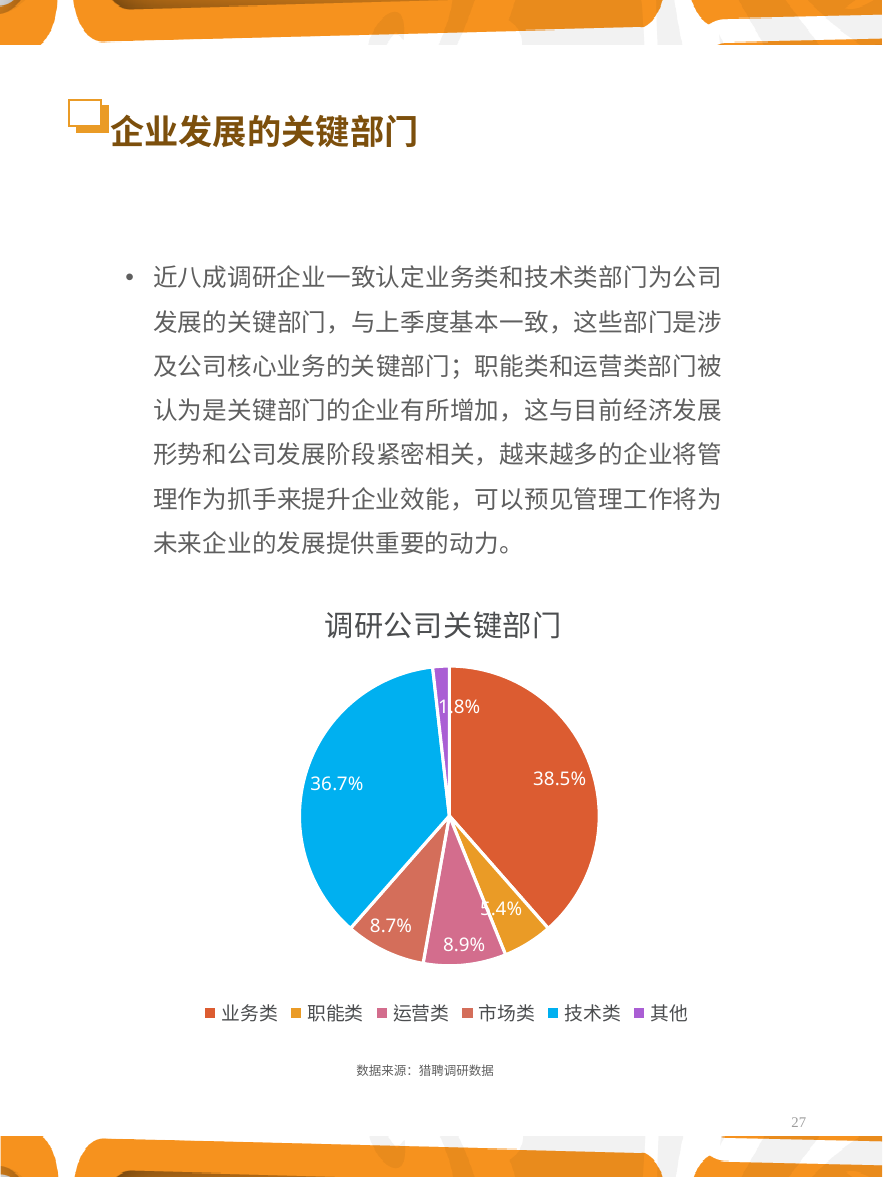
What share of the pie does 业务类 hold? 38.5% Which category has the smallest slice of the pie? 其他 What is the difference between the shares of 业务类 and 技术类? 1.8% How many categories does the legend list? 6 What is the title of the chart? 调研公司关键部门 What is the value shown for 运营类? 8.9% What type of chart is shown on the slide? pie chart Which category has the largest slice of the pie? 业务类 What is the value shown for 职能类? 5.4% Which is larger, the share for 职能类 or the share for 市场类? 市场类 What is the value shown for 市场类? 8.7% What share of the pie does 技术类 hold? 36.7%